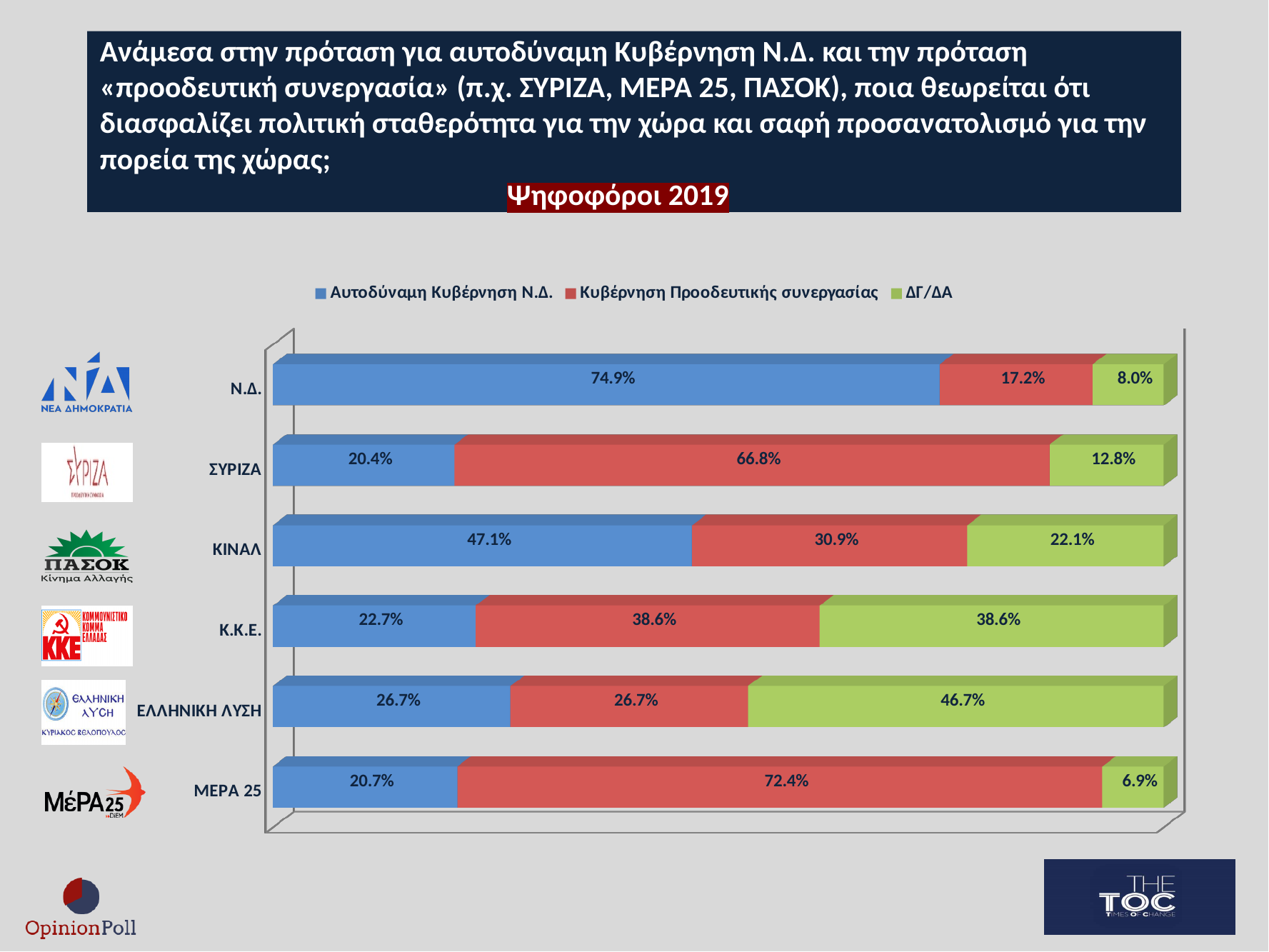
What is the ΔΓ/ΔΑ value for ΕΛΛΗΝΙΚΗ ΛΥΣΗ voters? 46.7% Which is larger for Κ.Κ.Ε. voters: Αυτοδύναμη Κυβέρνηση Ν.Δ. or ΔΓ/ΔΑ? ΔΓ/ΔΑ Which voter group has the lowest ΔΓ/ΔΑ value? ΜΕΡΑ 25 What is the value for Κυβέρνηση Προοδευτικής συνεργασίας among ΣΥΡΙΖΑ voters? 66.8% What kind of chart is shown on the slide? Stacked bar chart How many series does the legend list? 3 What is the total of the three segments for the ΚΙΝΑΛ bar? 100.1% What is the value for Αυτοδύναμη Κυβέρνηση Ν.Δ. among Ν.Δ. voters? 74.9% Which colour represents Κυβέρνηση Προοδευτικής συνεργασίας in the chart? Red What is the difference between the Αυτοδύναμη Κυβέρνηση Ν.Δ. value for Ν.Δ. voters and for ΚΙΝΑΛ voters? 27.8 percentage points Which voter group has the highest value for Κυβέρνηση Προοδευτικής συνεργασίας? ΜΕΡΑ 25 How many voter groups (categories) are plotted on the chart? 6